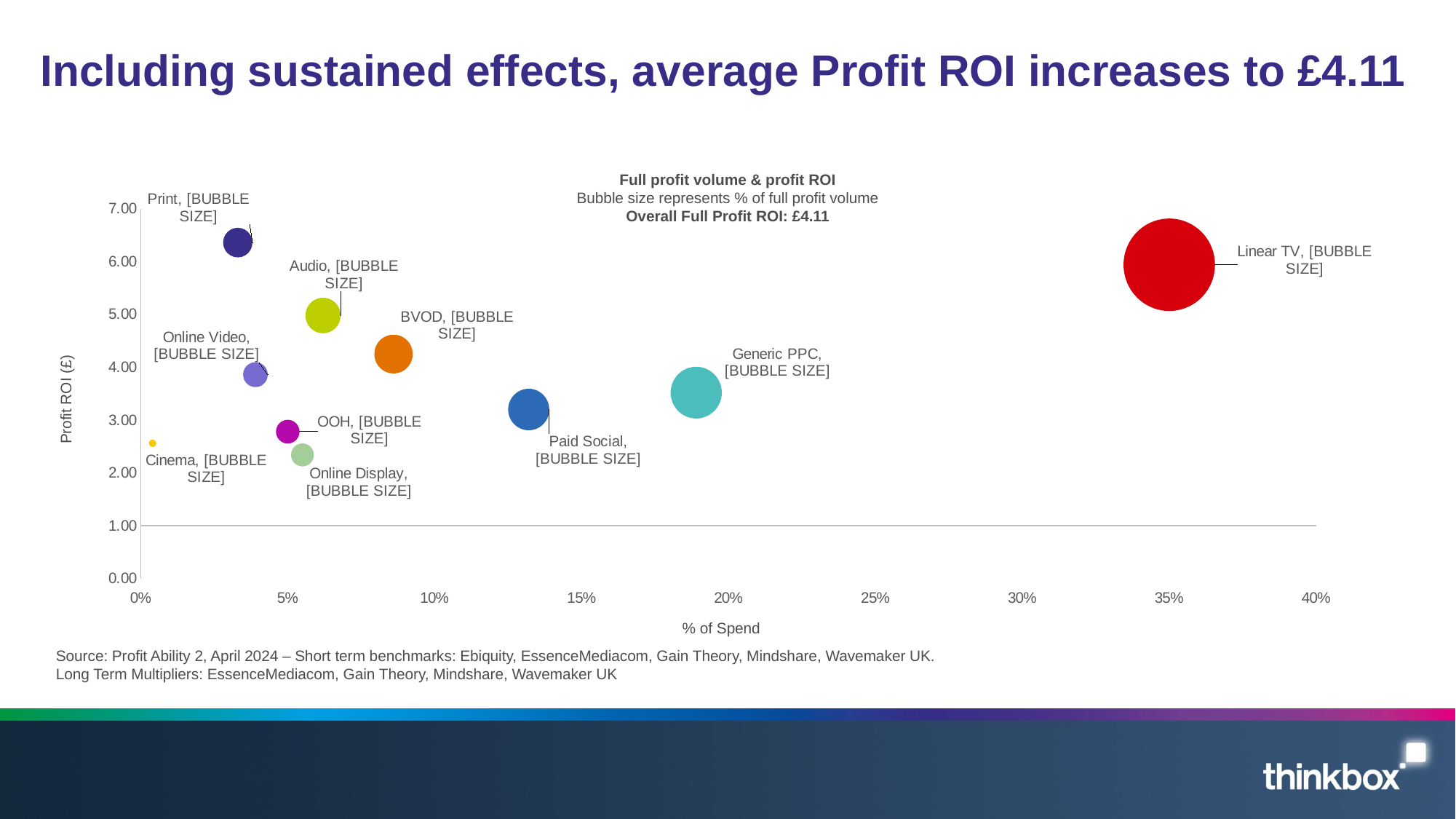
Which has the higher Profit ROI, Audio or BVOD? Audio Which channel has the largest bubble (largest share of full profit volume)? Linear TV Is the Profit ROI for Generic PPC greater or less than 4.00? less How many media channels (bubbles) are plotted on the chart? 10 What kind of chart is shown on the slide? Bubble chart Is the Profit ROI for Audio greater or less than 4.00? greater Is the % of Spend for Linear TV greater or less than 30%? greater Which channel has the lowest % of Spend? Cinema What Overall Full Profit ROI is stated in the chart's subtitle? £4.11 Which channel has the highest Profit ROI? Print Which has the higher % of Spend, Generic PPC or Paid Social? Generic PPC Which channel has the highest % of Spend? Linear TV